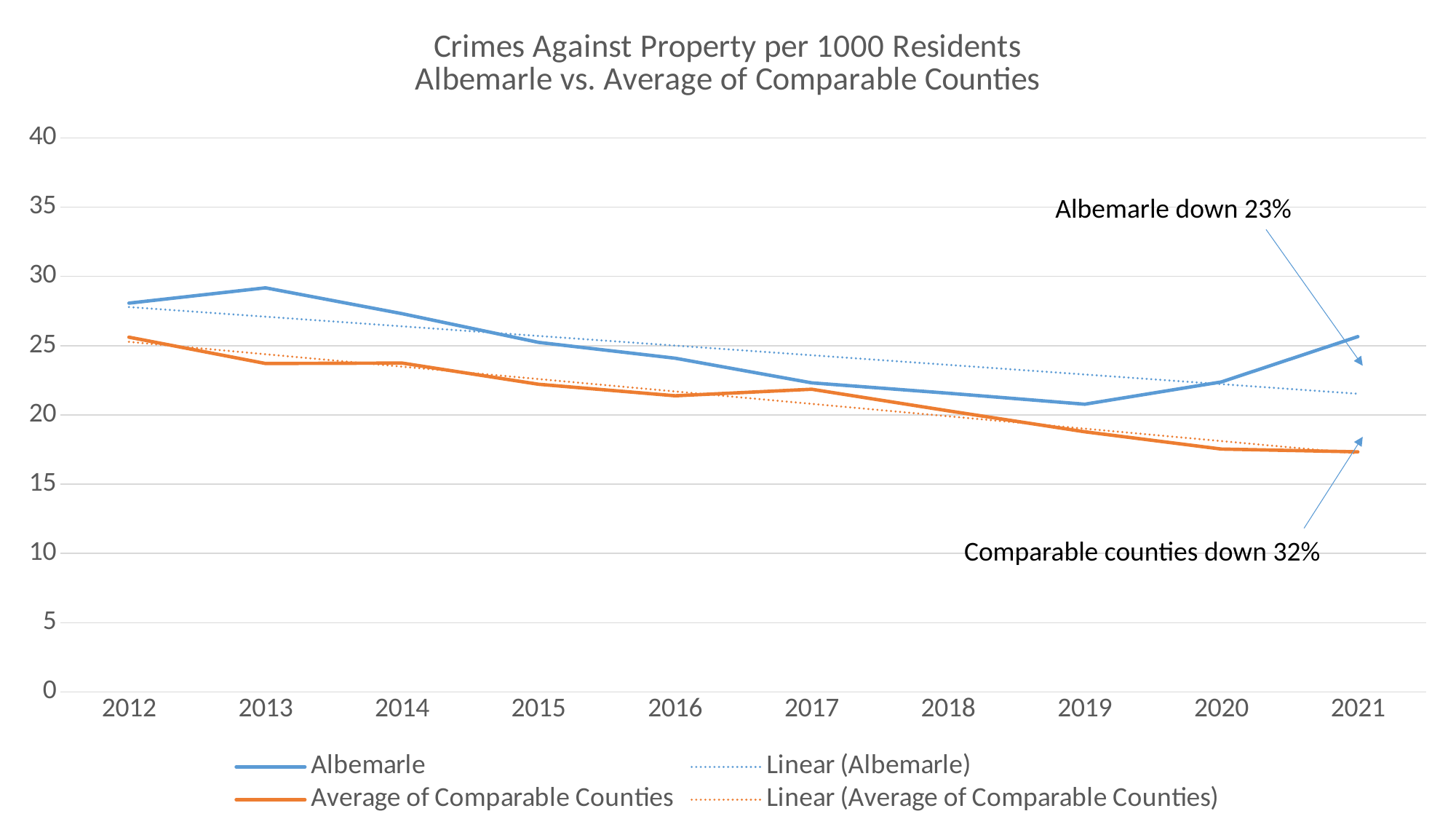
Is the Albemarle value for 2013 greater or less than 25? greater How many years are plotted along the x axis? 10 In which year does the Albemarle series reach its lowest value? 2019 According to the annotation on the chart, by what percentage are comparable counties down? 32% In which year is the Average of Comparable Counties series at its highest? 2012 Does the Average of Comparable Counties series generally rise or fall from 2012 to 2021? fall How many series does the legend list? 4 What kind of chart is shown on the slide? line chart Is the Average of Comparable Counties value for 2021 greater or less than 20? less In which year does the Albemarle series reach its highest value? 2013 In 2021, which is higher: Albemarle or Average of Comparable Counties? Albemarle Is the Albemarle value for 2019 greater or less than 25? less